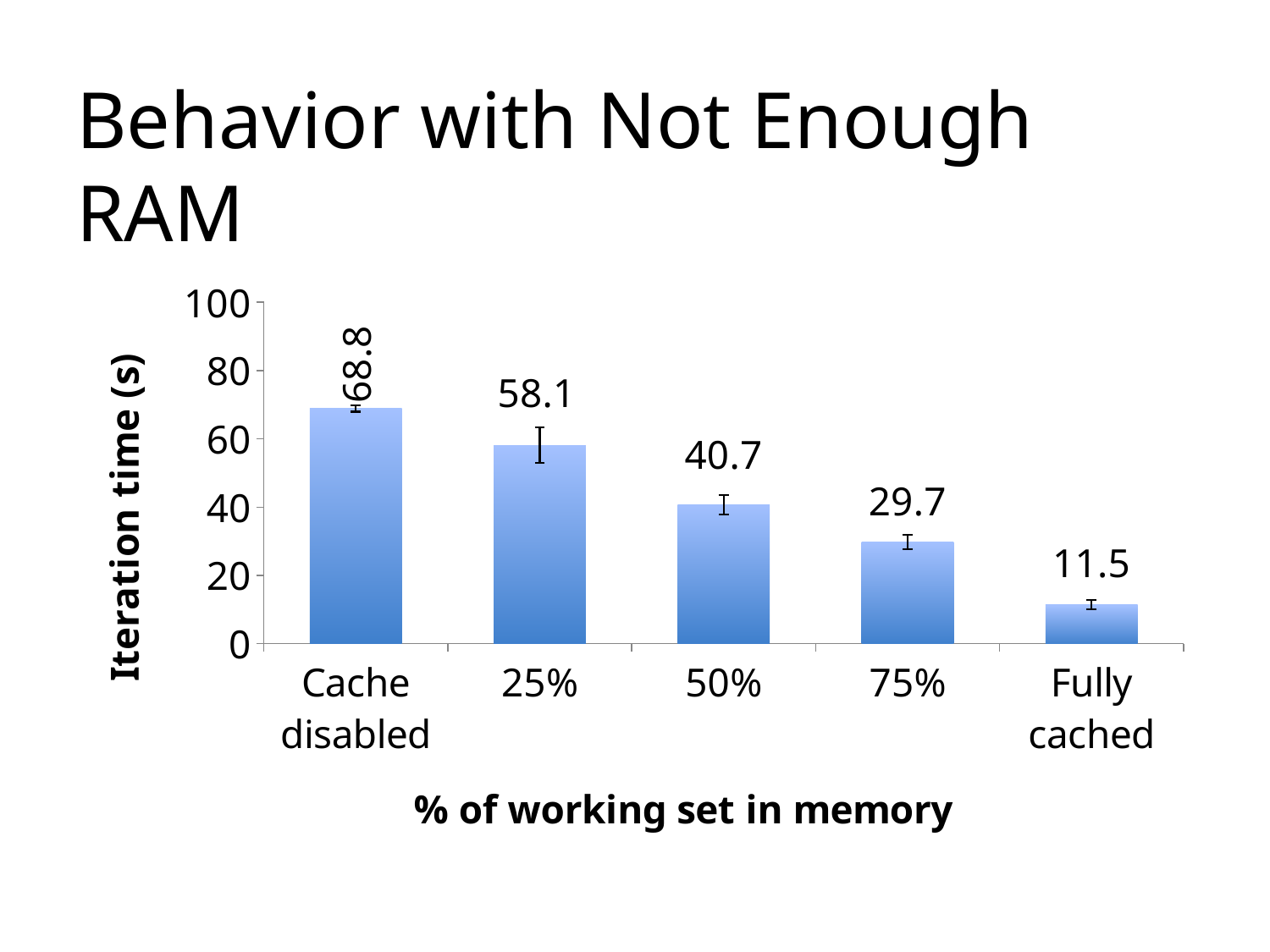
What kind of chart is shown on the slide? bar chart Which category has the lowest iteration time? Fully cached What is the iteration time when 50% of the working set is in memory? 40.7 Do the iteration times rise or fall from left to right along the x axis? fall What is the difference in iteration time between 25% and 75%? 28.4 What is the difference in iteration time between Cache disabled and Fully cached? 57.3 How many categories are shown on the x axis? 5 What is the iteration time for Cache disabled? 68.8 Which has a larger iteration time, 50% or 75%? 50% Which category has the highest iteration time? Cache disabled What is the iteration time for Fully cached? 11.5 Is the iteration time for 25% greater or less than 60? less